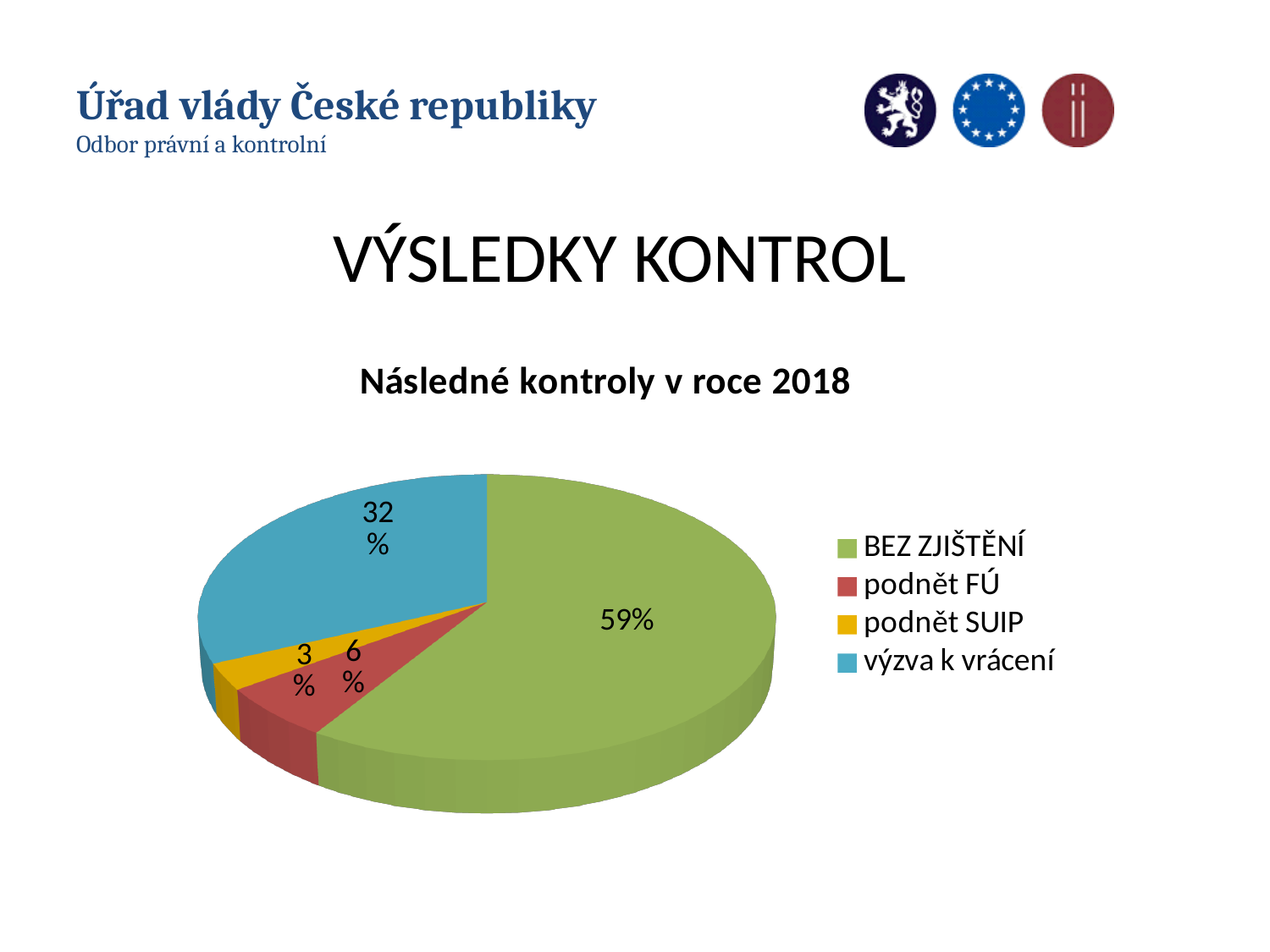
What kind of chart is shown on the slide? Pie chart What is the value shown for podnět SUIP? 3% What share of the pie does BEZ ZJIŠTĚNÍ represent? 59% What colour is the slice for výzva k vrácení? Blue Which category has the largest slice of the pie? BEZ ZJIŠTĚNÍ How many categories are shown in the pie chart? 4 What is the value shown for podnět FÚ? 6% Which is larger, the share for podnět FÚ or the share for podnět SUIP? podnět FÚ What is the title of the chart? Následné kontroly v roce 2018 What is the difference between the shares of BEZ ZJIŠTĚNÍ and výzva k vrácení? 27% What share of the pie does výzva k vrácení represent? 32% Which category has the smallest slice of the pie? podnět SUIP